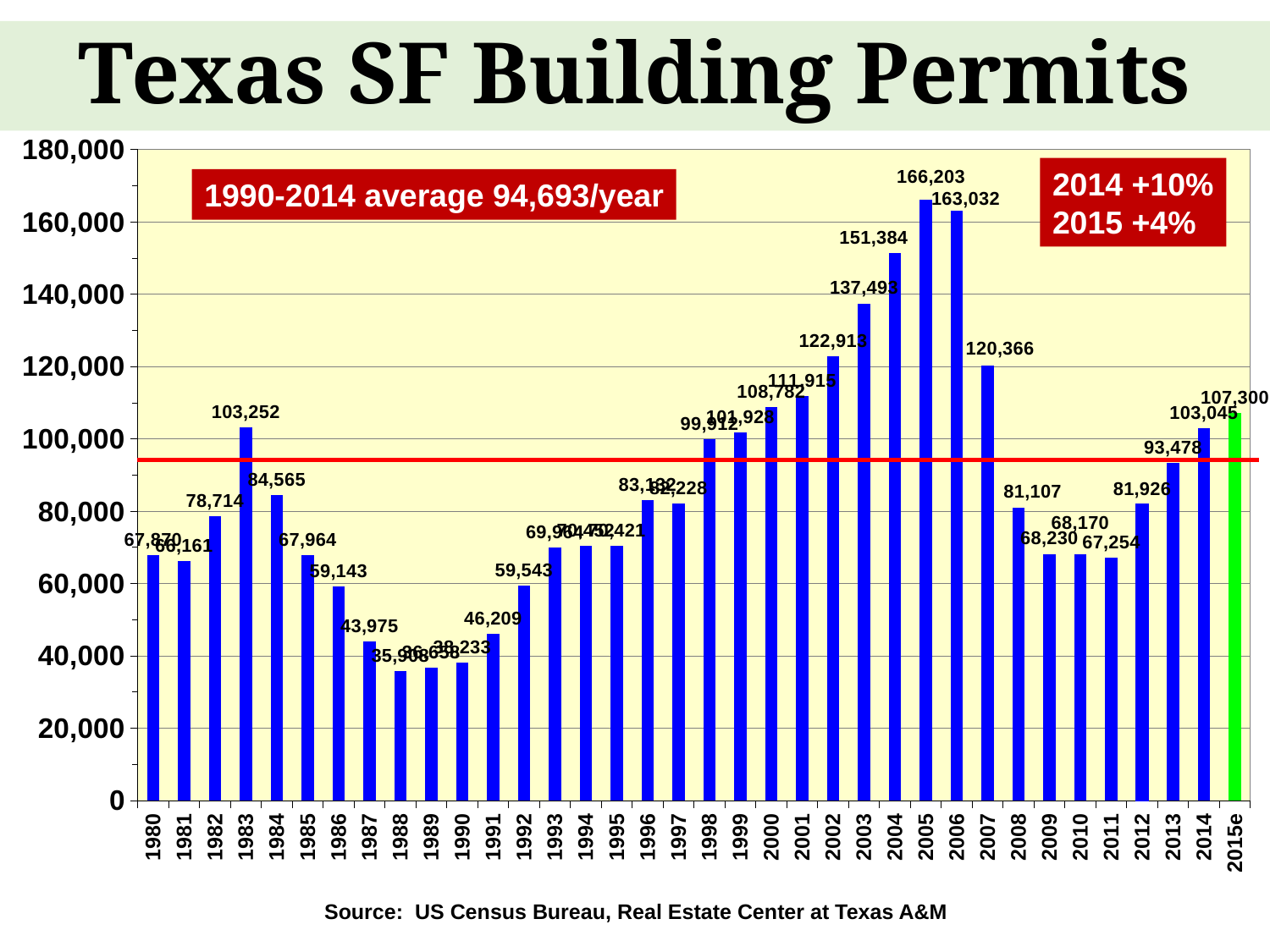
Is the value for 1988 greater or less than 40,000? less What kind of chart is shown on the slide? bar chart What is the value shown for 2005? 166,203 What is the difference between the values for 2005 and 2006? 3,171 What is the estimated value shown for 2015e? 107,300 How many years (bars) are shown on the chart? 36 What is the difference between the values for 2014 and 2013? 9,567 What is the value shown for 2007? 120,366 Which year has the highest number of Texas SF building permits? 2005 Do the values rise or fall from 2007 to 2011? fall What is the value shown for 1983? 103,252 Which is larger, the value for 2013 or the value for 2014? 2014